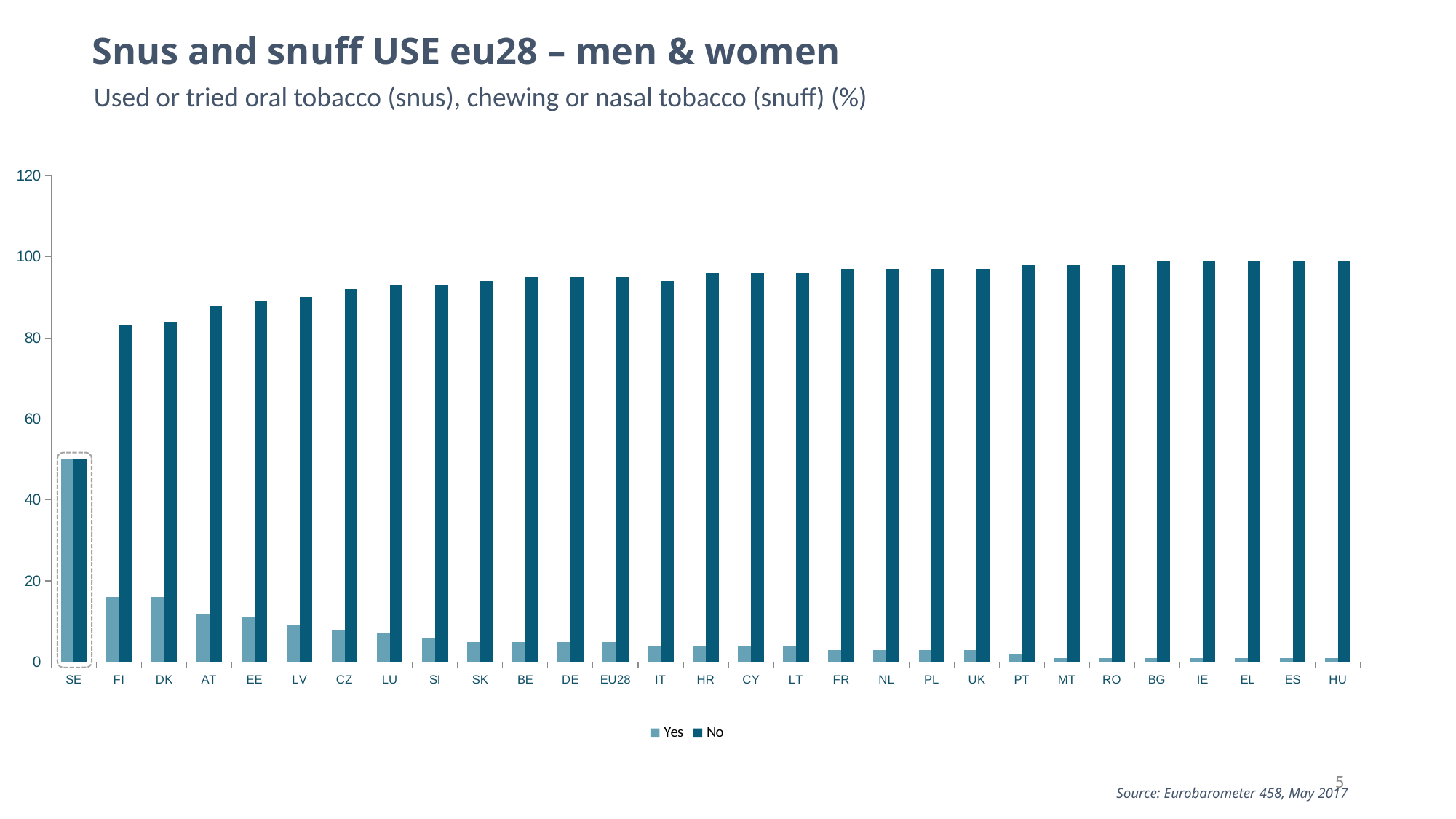
Which category has the lowest value for the No series? SE How many series does the legend list? 2 Which has the larger Yes value, SE or FI? SE Do the Yes values rise or fall moving from left to right along the x axis? fall Which has the larger No value, FI or HU? HU Is the No value for FI greater or less than 80? greater What kind of chart is shown on the slide? bar chart Which category has the highest value for the Yes series? SE Is the Yes value for FI greater or less than 20? less How many categories are shown along the x axis? 29 Is the Yes value for SE greater or less than 40? greater What are the two series named in the legend? Yes and No